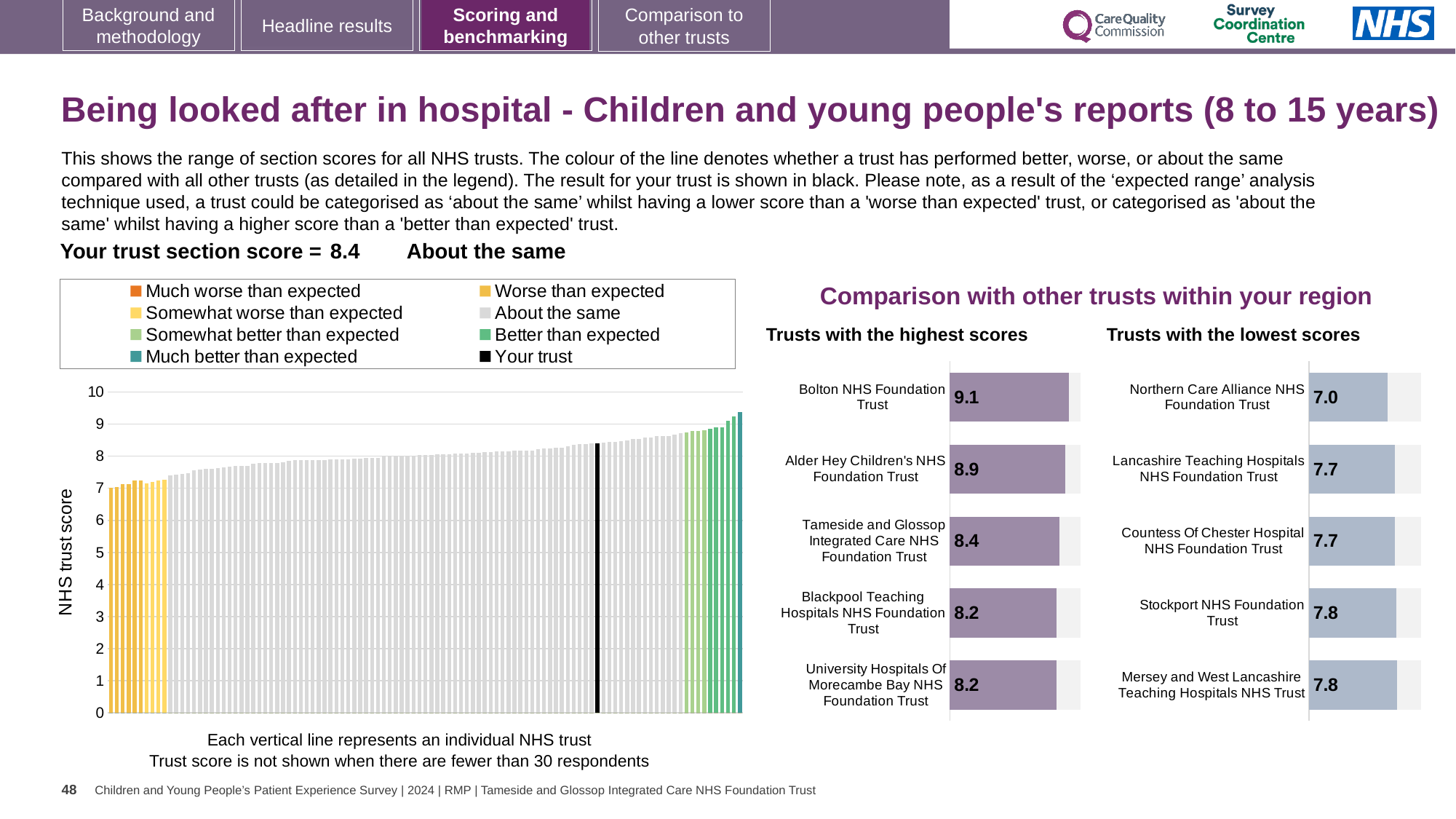
How many entries does the legend above the 'NHS trust score' chart list? 8 In the 'Trusts with the highest scores' chart, what is the score for Bolton NHS Foundation Trust? 9.1 In the 'Trusts with the lowest scores' chart, what is the score for Northern Care Alliance NHS Foundation Trust? 7.0 How many trusts are shown in the 'Trusts with the highest scores' chart? 5 What kind of chart is the 'NHS trust score' chart on the left of the slide? Bar chart In the 'Trusts with the highest scores' chart, what is the difference between the scores of Bolton NHS Foundation Trust and Alder Hey Children's NHS Foundation Trust? 0.2 How many trusts are shown in the 'Trusts with the lowest scores' chart? 5 In the 'Trusts with the lowest scores' chart, which trust has the lowest score? Northern Care Alliance NHS Foundation Trust In the 'NHS trust score' chart on the left, do the values rise or fall from left to right? Rise In the 'NHS trust score' chart on the left, is the value of the black bar (your trust) greater or less than 8? greater In the 'Trusts with the lowest scores' chart, which has the larger score: Stockport NHS Foundation Trust or Lancashire Teaching Hospitals NHS Foundation Trust? Stockport NHS Foundation Trust In the 'Trusts with the highest scores' chart, which trust has the highest score? Bolton NHS Foundation Trust